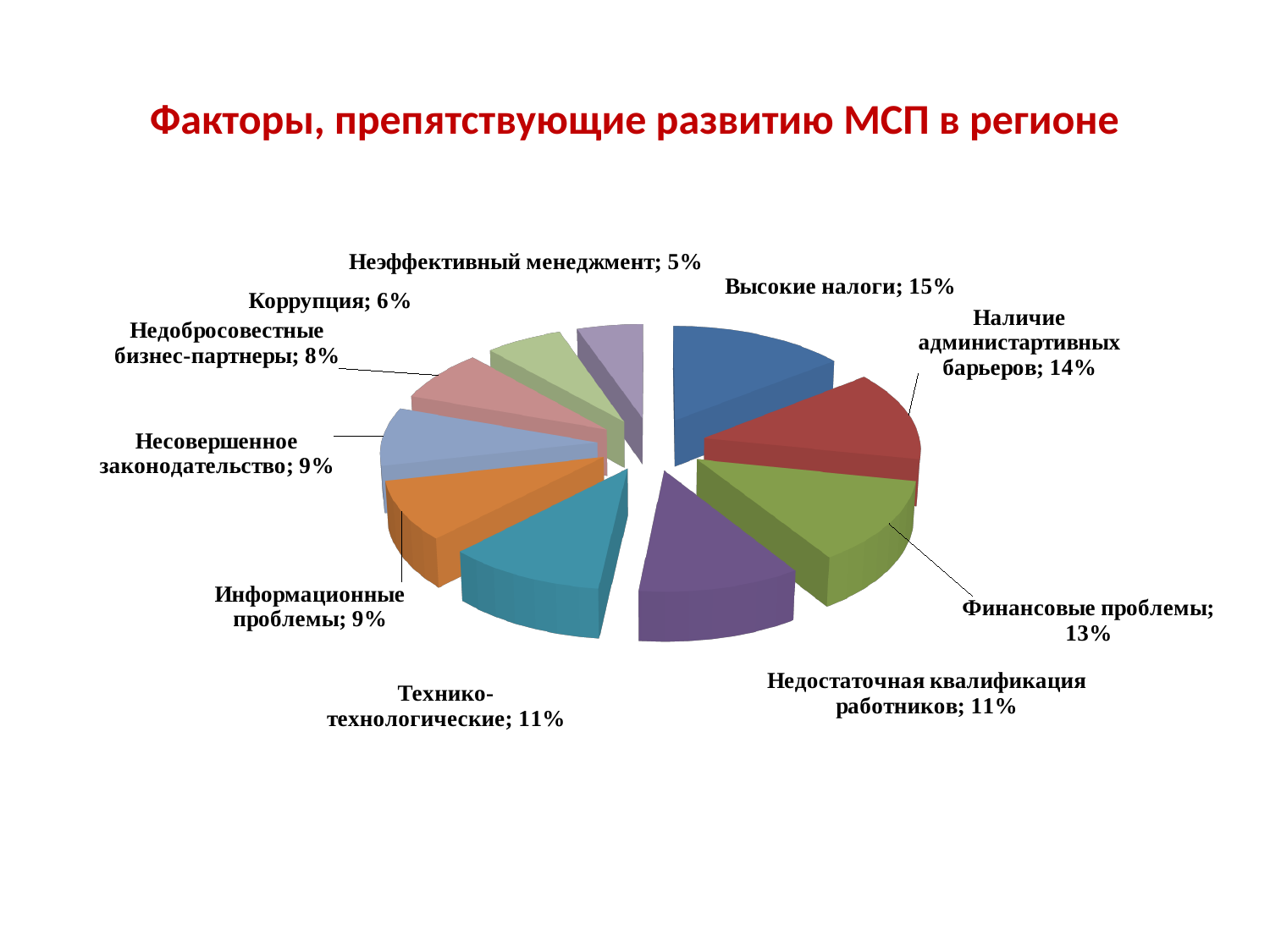
Which factor has the largest share of the pie? Высокие налоги What percentage is shown for "Финансовые проблемы"? 13% What is the title of the chart on the slide? Факторы, препятствующие развитию МСП в регионе What percentage is shown for "Недобросовестные бизнес-партнеры"? 8% What is the difference in percentage points between "Наличие администартивных барьеров" and "Неэффективный менеджмент"? 9 Which factor has the smallest share of the pie? Неэффективный менеджмент What share of the pie does "Высокие налоги" account for? 15% Which is larger: the share for "Технико-технологические" or the share for "Информационные проблемы"? Технико-технологические What kind of chart is shown on the slide? Pie chart How many slices does the pie chart have? 10 What percentage is shown for "Коррупция"? 6% What percentage is shown for "Недостаточная квалификация работников"? 11%